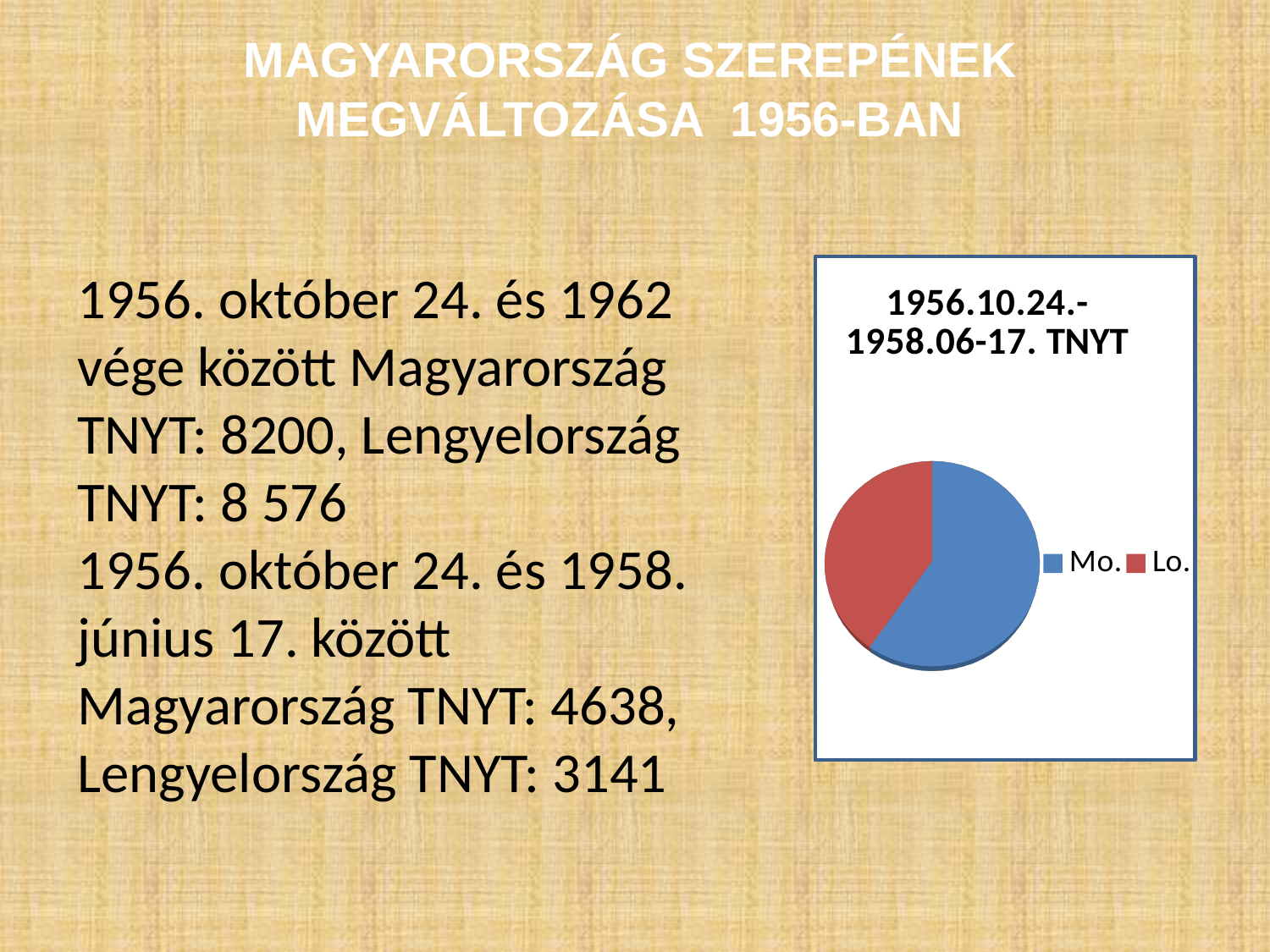
Which slice of the pie chart is the largest? Mo. In the pie chart, which is larger, the slice for Mo. or the slice for Lo.? Mo. Which slice of the pie chart is the smallest? Lo. How many entries does the legend of the pie chart list? 2 What colour is the Mo. slice in the pie chart? blue How many slices does the pie chart have? 2 Does the Mo. slice take up more or less than half of the pie chart? more What is the title of the pie chart? 1956.10.24.-1958.06-17. TNYT Does the Lo. slice take up more or less than half of the pie chart? less What kind of chart is shown on the slide? pie chart